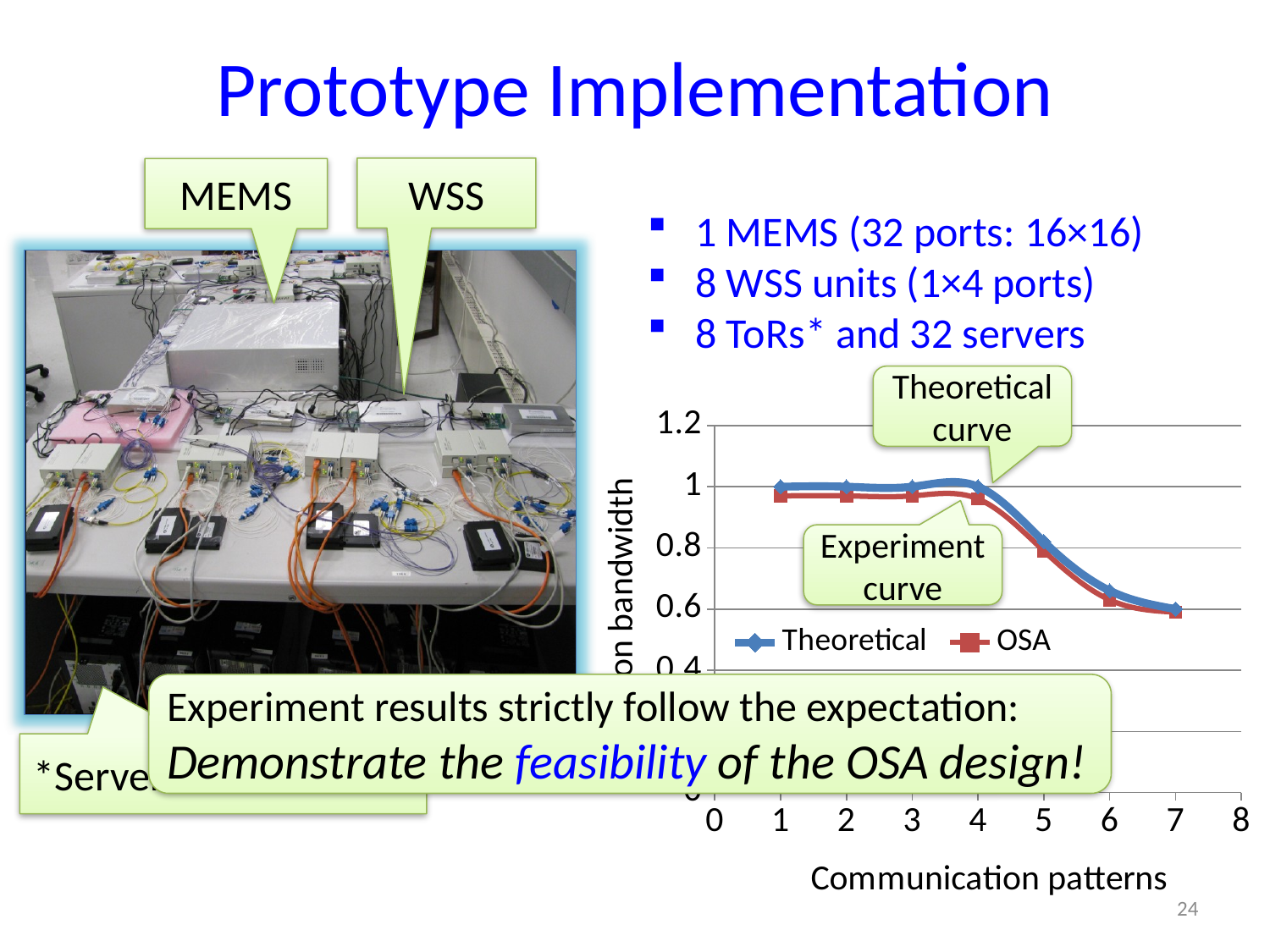
How many series does the chart legend list? 2 Do the values of the Theoretical series rise or fall as the communication pattern number increases from 1 to 7? fall What kind of chart is shown on the slide? line chart Is the OSA value at communication pattern 7 greater or less than 0.8? less What is the x-axis title of the chart? Communication patterns Is the OSA value at communication pattern 2 greater or less than 0.8? greater How many data points does the OSA series have? 7 At communication pattern 5, which series has the larger value, Theoretical or OSA? Theoretical Which communication pattern has the lowest value for the OSA series? 7 What are the two series named in the chart legend? Theoretical and OSA Is the Theoretical value at communication pattern 1 greater or less than 0.8? greater